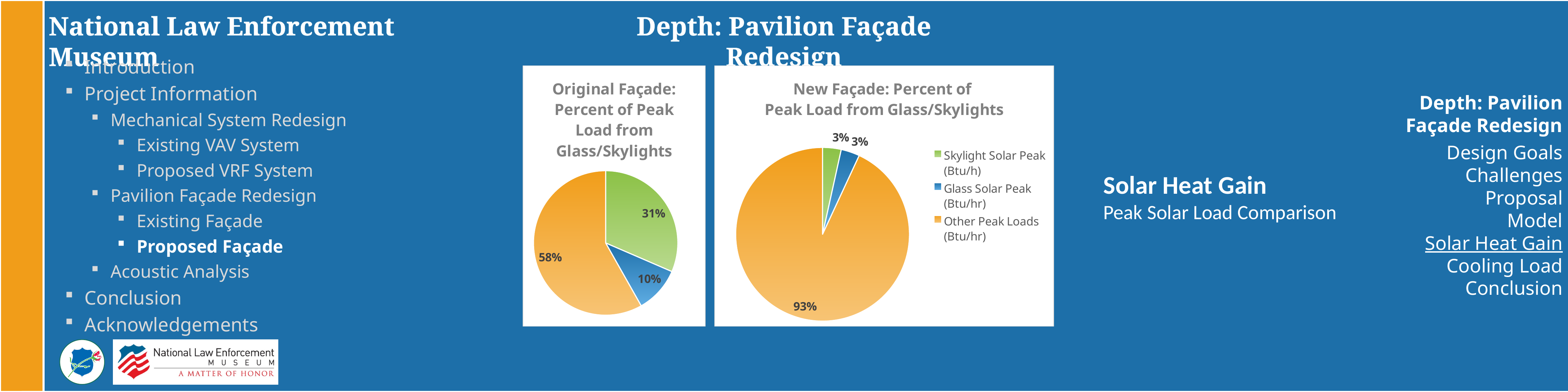
In the 'New Façade: Percent of Peak Load from Glass/Skylights' chart, what share is Glass Solar Peak (Btu/hr)? 3% What kind of chart is the 'Original Façade: Percent of Peak Load from Glass/Skylights' chart? pie chart In the 'Original Façade: Percent of Peak Load from Glass/Skylights' chart, which slice is the smallest? the blue slice (10%) In the 'Original Façade: Percent of Peak Load from Glass/Skylights' chart, what share does the blue slice represent? 10% In the 'Original Façade: Percent of Peak Load from Glass/Skylights' chart, what share does the orange slice represent? 58% In the 'Original Façade: Percent of Peak Load from Glass/Skylights' chart, what is the difference between the green slice and the blue slice? 21 percentage points In the 'Original Façade: Percent of Peak Load from Glass/Skylights' chart, which slice is the largest? the orange slice (58%) How many slices does the 'New Façade: Percent of Peak Load from Glass/Skylights' pie chart have? 3 How many entries does the legend of the 'New Façade: Percent of Peak Load from Glass/Skylights' chart list? 3